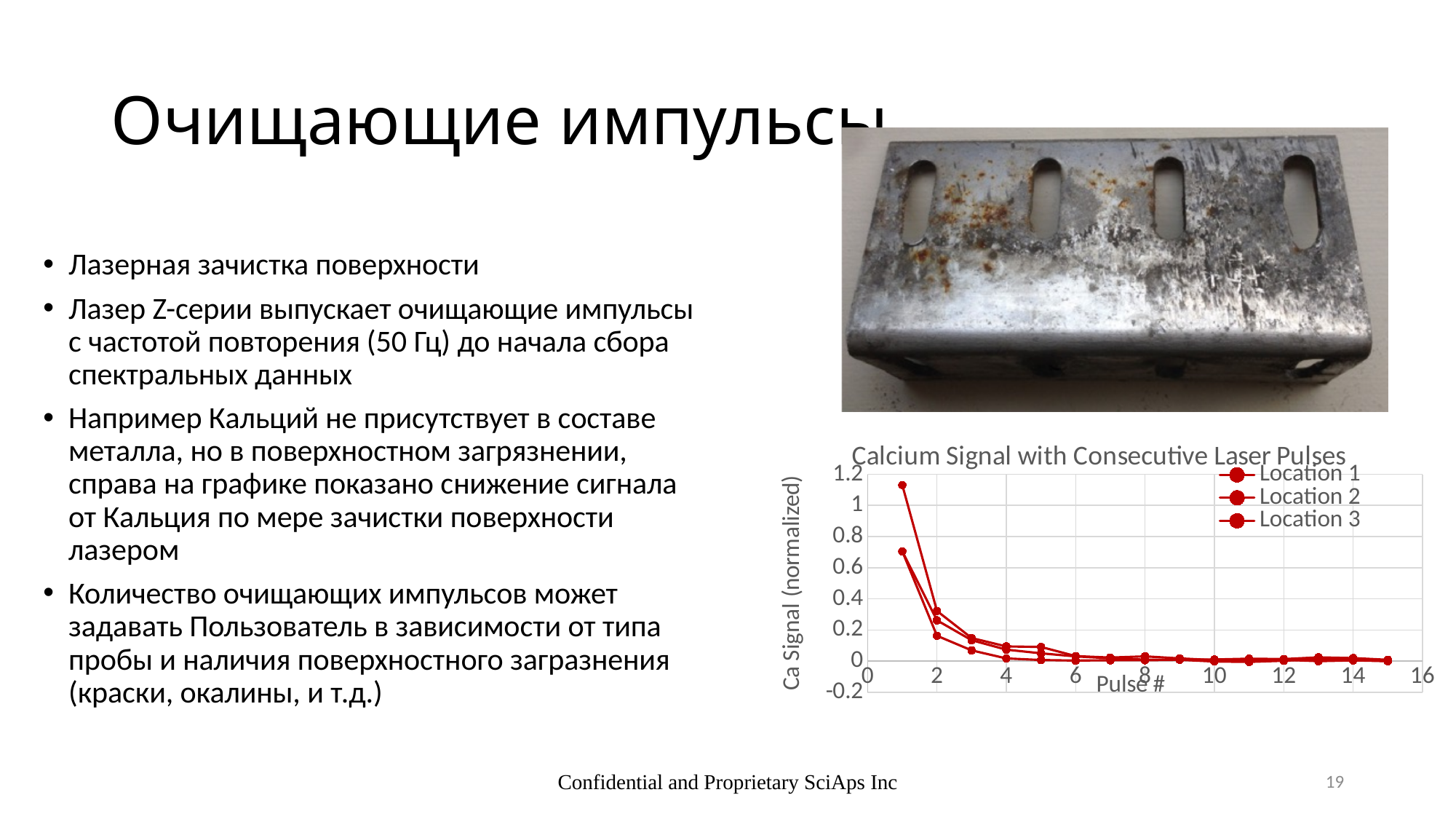
What is the label of the chart's x axis? Pulse # Is the lowest plotted value at pulse 2 greater or less than 0.4? less What is the title of the chart? Calcium Signal with Consecutive Laser Pulses Are all plotted values at pulse 10 greater or less than 0.2? less How many series does the chart's legend list? 3 How many data points does each series have? 15 What kind of chart is shown on the slide? Line chart Is the highest plotted value at pulse 1 greater or less than 1? greater What is the highest value shown on the y axis? 1.2 Do the plotted values rise or fall as the pulse number increases? Fall At which pulse number do the series reach their highest values? 1